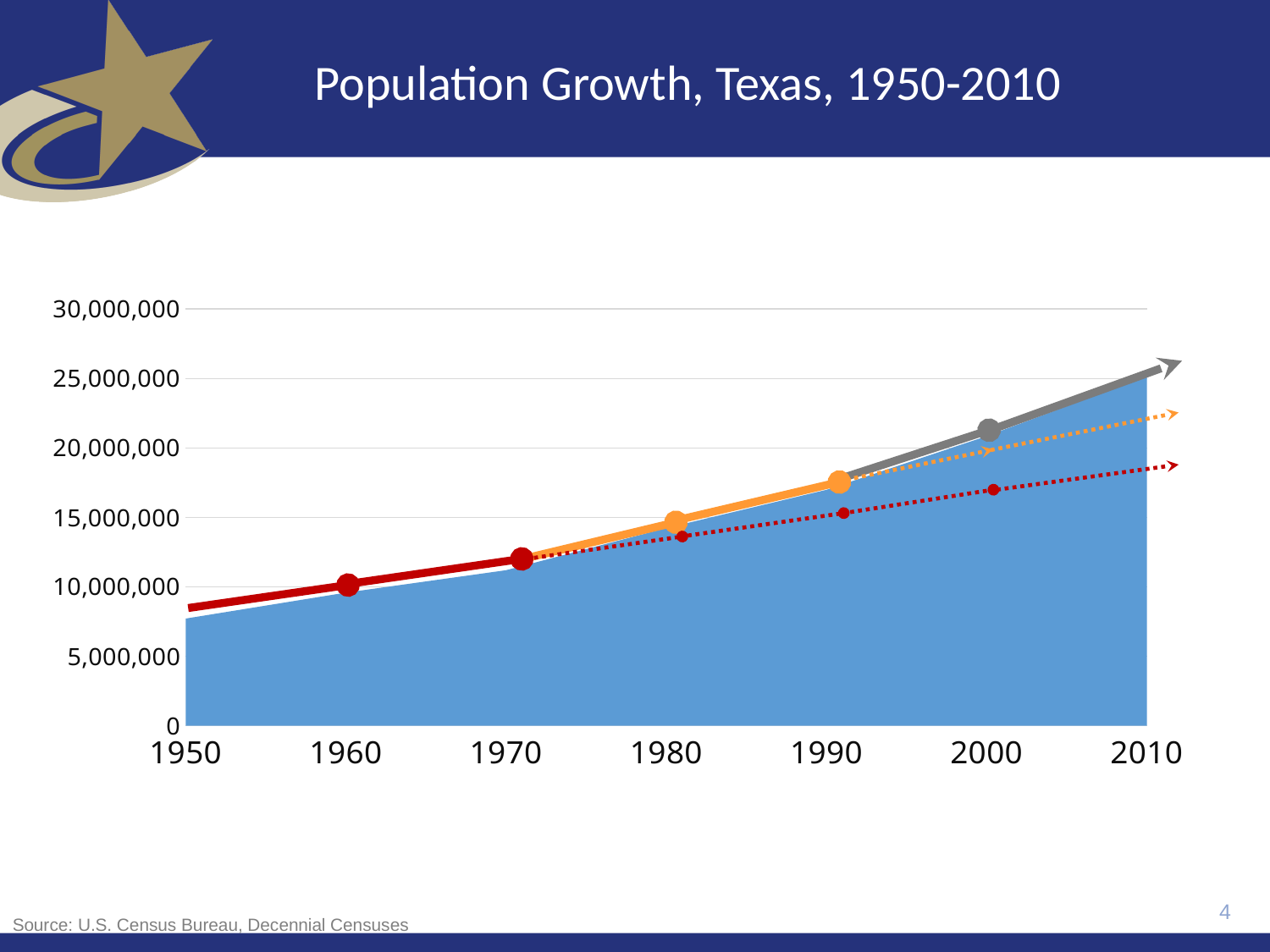
Is the value for 2010 greater or less than 20,000,000? greater What is the title of the chart? Population Growth, Texas, 1950-2010 Is the value for 1980 greater or less than 15,000,000? less Is the value for 1950 greater or less than 10,000,000? less Which year has the lowest population value? 1950 Which year has the highest population value? 2010 What kind of chart is shown on the slide? area chart Which year has the larger population value, 1970 or 2000? 2000 Does the population rise or fall from 1950 to 2010? rise How many years are labelled on the x axis of the chart? 7 What source is cited for the chart data? U.S. Census Bureau, Decennial Censuses